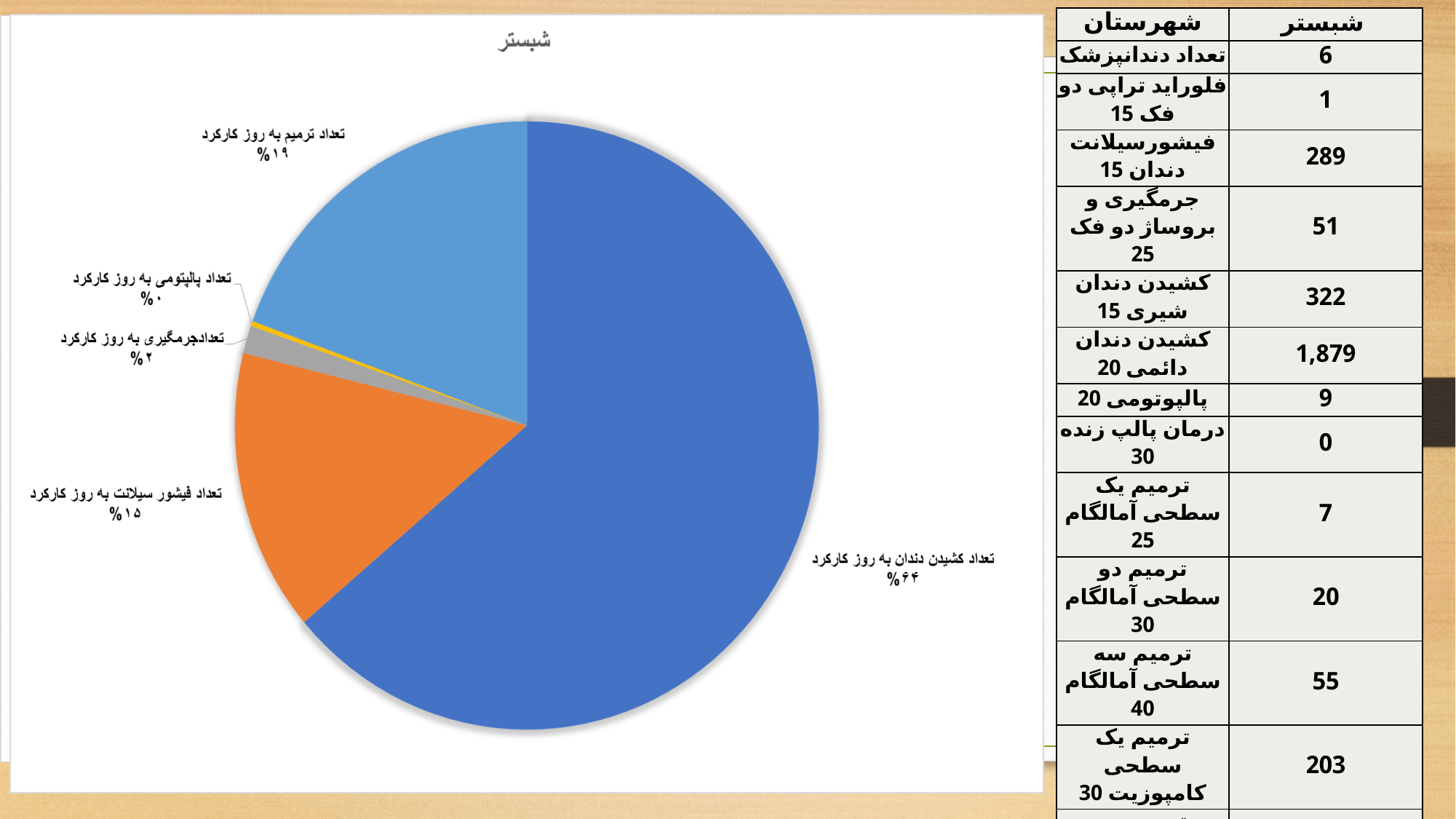
What share of the pie does "تعدادجرمگیری به روز کارکرد" have? ۲% What share of the pie does "تعداد ترمیم به روز کارکرد" have? ۱۹% What share of the pie does "تعداد کشیدن دندان به روز کارکرد" have? ۶۴% Which is larger: the share for "تعداد ترمیم به روز کارکرد" or for "تعداد فیشور سیلانت به روز کارکرد"? تعداد ترمیم به روز کارکرد Which category has the smallest slice of the pie? تعداد پالپتومی به روز کارکرد What is the difference in percentage points between the share for "تعداد کشیدن دندان به روز کارکرد" and the share for "تعداد ترمیم به روز کارکرد"? 45 What type of chart is shown on the slide? pie chart What is the title of the pie chart? شبستر How many slices does the pie chart have? 5 Which category has the largest slice of the pie? تعداد کشیدن دندان به روز کارکرد